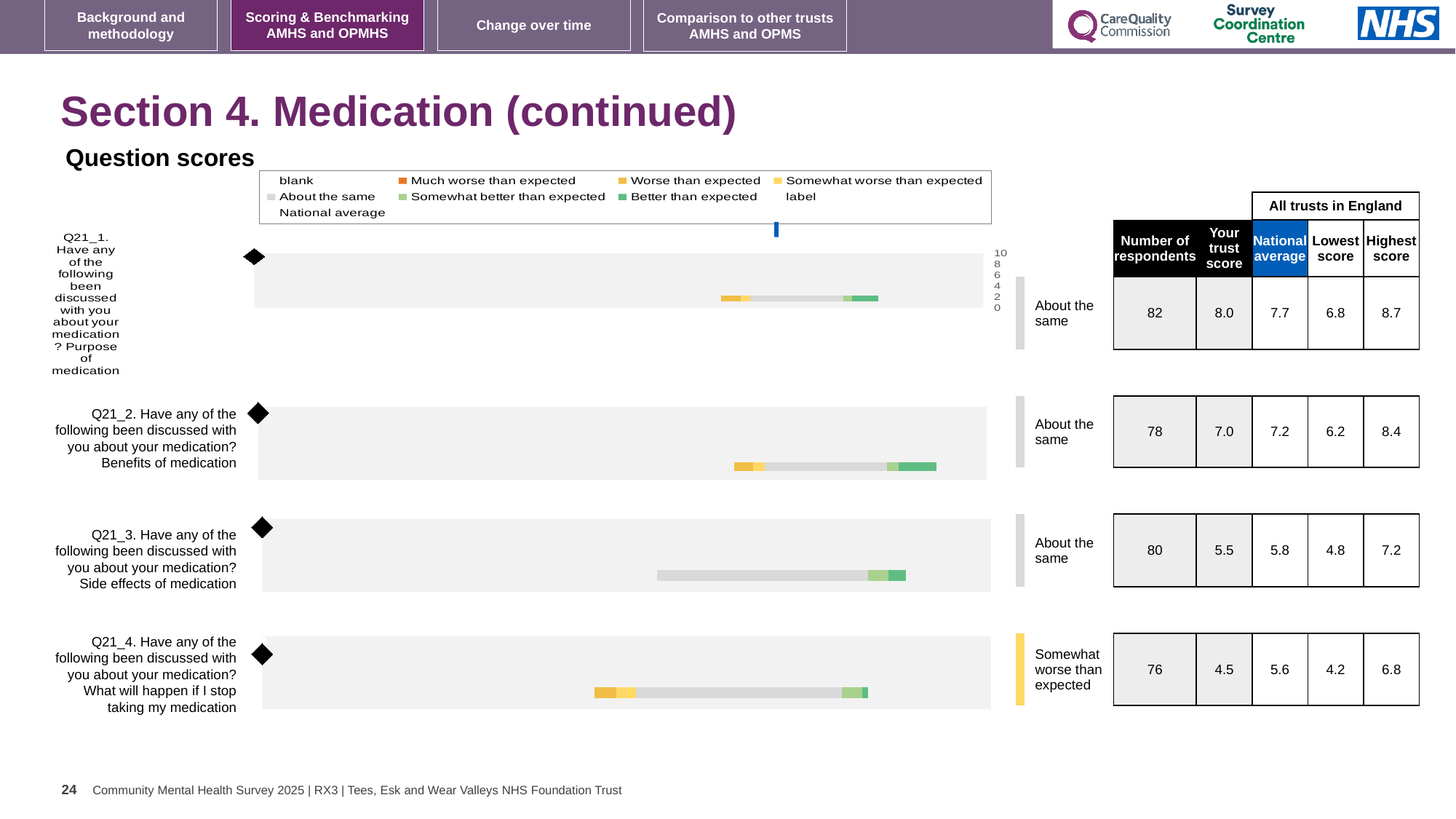
Which question is rated 'Somewhat worse than expected'? Q21_4 Which question has the lowest trust score on this slide? Q21_4 (What will happen if I stop taking my medication) What is the highest score among all trusts in England for Q21_3? 7.2 What is the trust score for Q21_2 (Benefits of medication)? 7.0 Which question has the highest trust score on this slide? Q21_1 (Purpose of medication) How many questions (Q21_1 to Q21_4) have a score bar on this slide? 4 What is the national average for Q21_4 (What will happen if I stop taking my medication)? 5.6 How many respondents answered Q21_3 (Side effects of medication)? 80 For Q21_1, what is the difference between the highest score and the lowest score across all trusts in England? 1.9 For Q21_2, which is larger: the trust score or the national average? national average How many entries does the chart legend list? 9 What kind of chart is used to show the question scores on this slide? bar chart